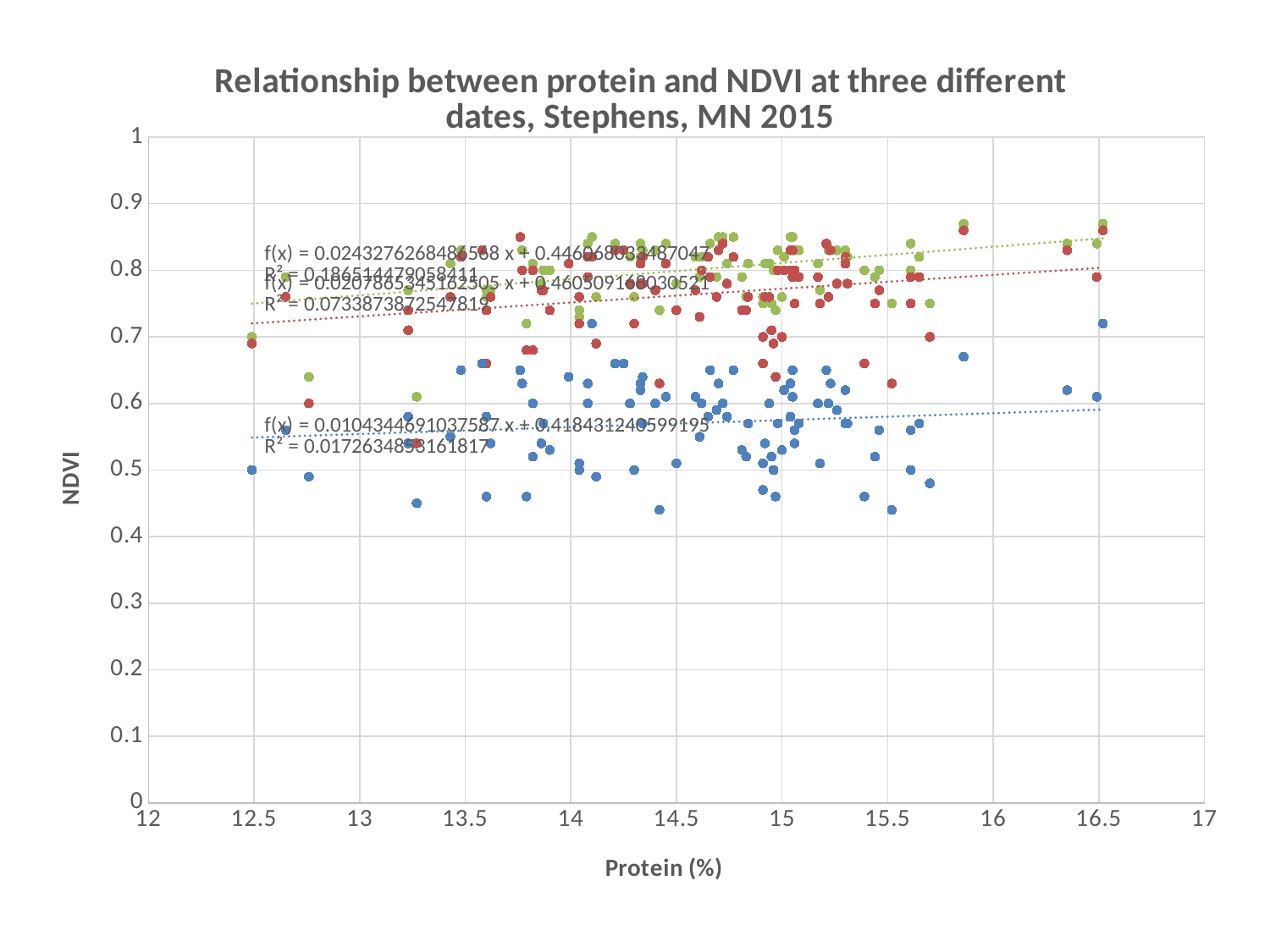
What is the maximum value shown on the vertical (NDVI) axis? 1 Which colour of points generally has the lowest NDVI values: blue, red or green? Blue What is the label of the horizontal axis? Protein (%) What is the R² value printed for the lowest (blue) trendline? 0.0172634853161817 What is the title of the chart? Relationship between protein and NDVI at three different dates, Stephens, MN 2015 What is the minimum value shown on the horizontal (Protein) axis? 12 How many series of points (colours) are plotted on the chart? 3 Do the dotted trendlines rise or fall as protein increases? Rise What kind of chart is shown on the slide? Scatter chart Is the NDVI value of the blue point at protein 12.5 greater or less than 0.6? less Is the NDVI value of the green point at protein 15.85 greater or less than 0.8? greater What is the slope (coefficient of x) in the equation printed for the lowest (blue) trendline? 0.0104344691037587